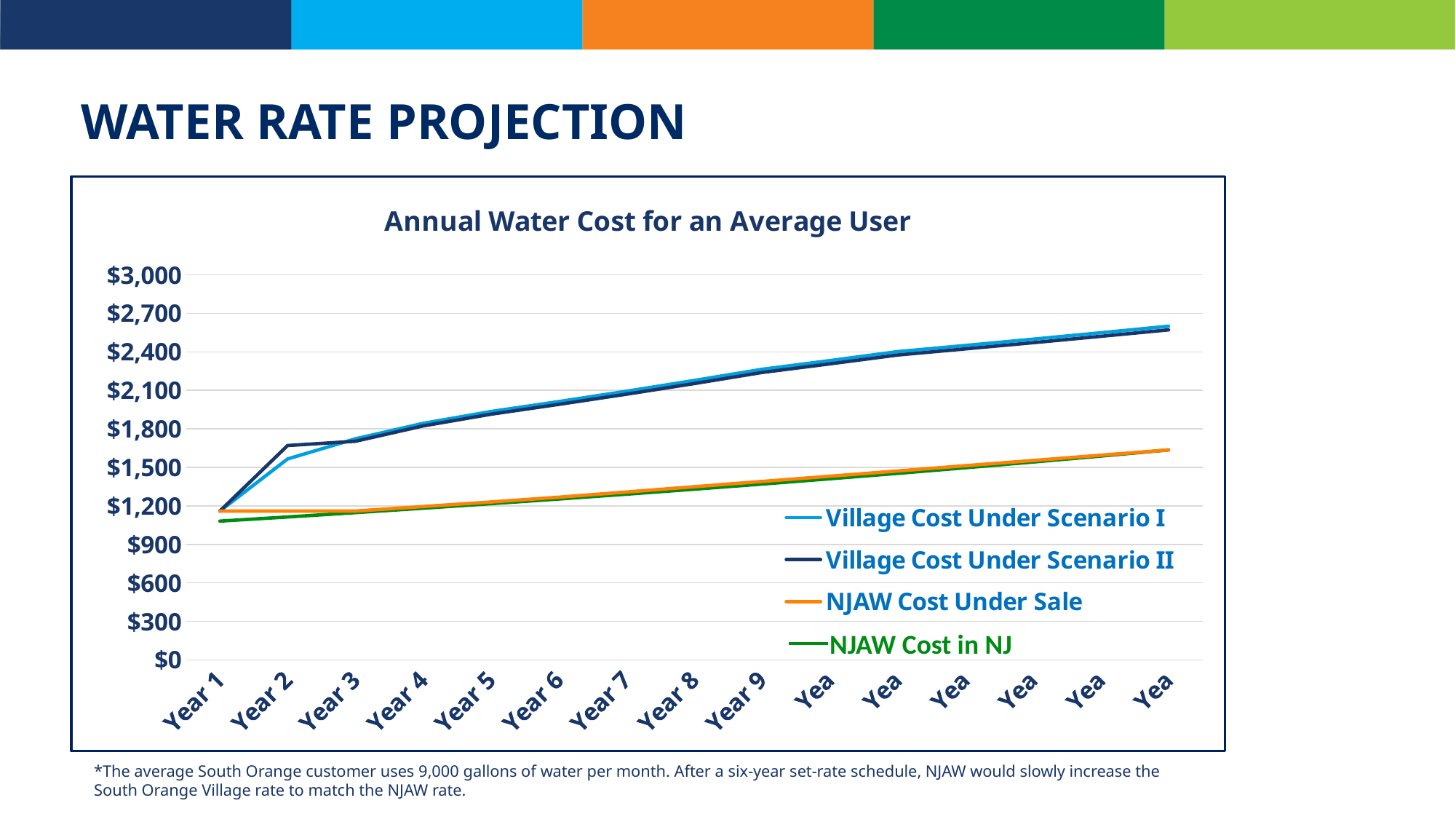
How many year categories are plotted along the x axis? 15 Is the value for NJAW Cost Under Sale in Year 5 greater or less than $1,500? less Does the Village Cost Under Scenario I rise or fall from Year 1 to the final year? rise What is the title of the chart? Annual Water Cost for an Average User Is the value for Village Cost Under Scenario II in Year 2 greater or less than $1,500? greater How many series does the legend list? 4 Which colour is used for the NJAW Cost in NJ line? green What kind of chart is shown on the slide? line chart In Year 2, which is higher: Village Cost Under Scenario I or Village Cost Under Scenario II? Village Cost Under Scenario II Is the value for NJAW Cost in NJ in Year 1 greater or less than $1,200? less In Year 5, which is higher: Village Cost Under Scenario I or NJAW Cost Under Sale? Village Cost Under Scenario I